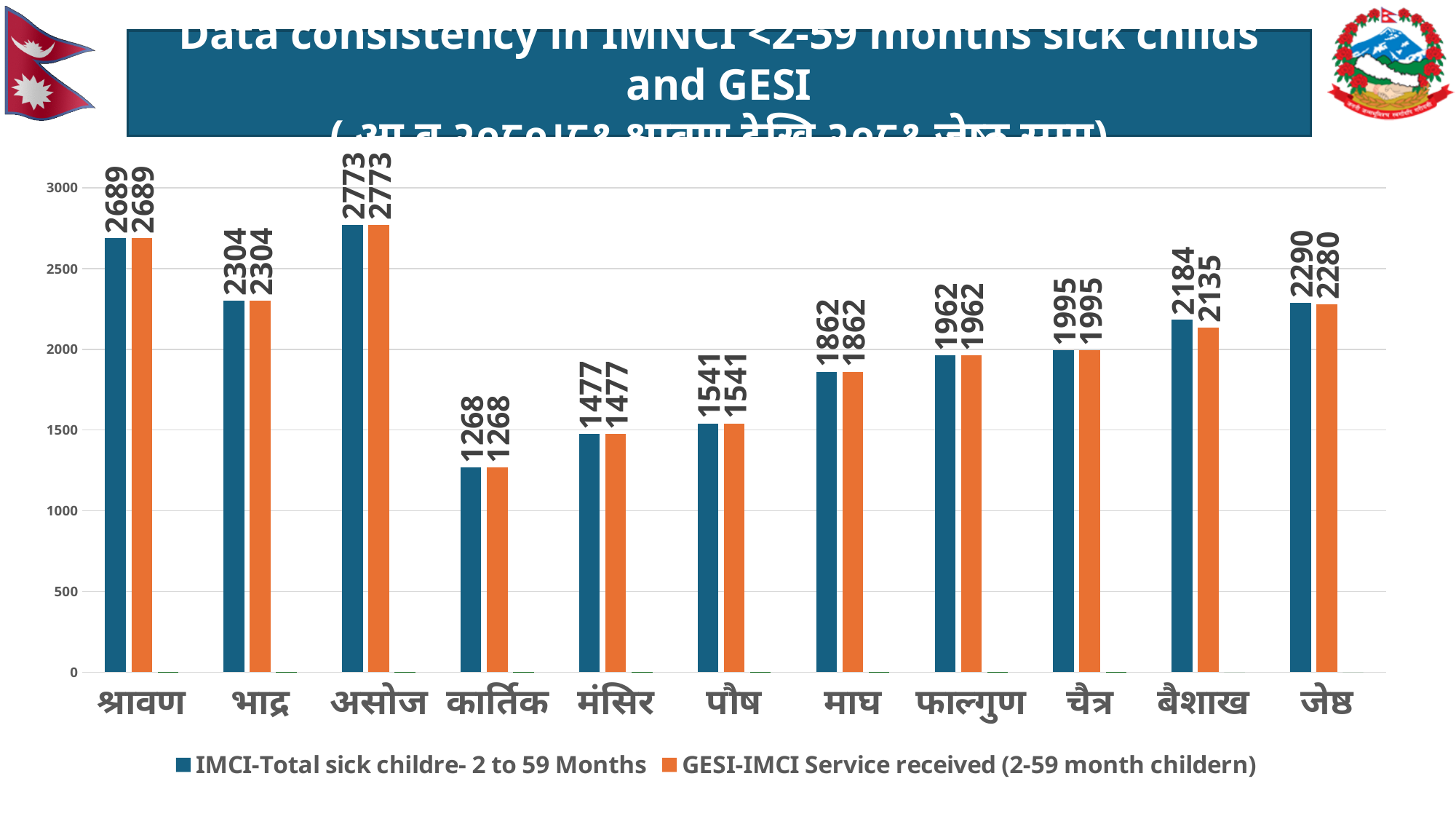
What is the value of IMCI-Total sick childre- 2 to 59 Months for श्रावण? 2689 Which month has the highest value for IMCI-Total sick childre- 2 to 59 Months? असोज What type of chart is shown on the slide? bar chart Which is larger for जेष्ठ: IMCI-Total sick childre- 2 to 59 Months or GESI-IMCI Service received (2-59 month childern)? IMCI-Total sick childre- 2 to 59 Months Which month has the lowest value for GESI-IMCI Service received (2-59 month childern)? कार्तिक What is the difference between IMCI-Total sick childre- 2 to 59 Months and GESI-IMCI Service received for बैशाख? 49 What is the value of GESI-IMCI Service received (2-59 month childern) for बैशाख? 2135 Which colour represents GESI-IMCI Service received (2-59 month childern) in the chart? orange What is the value of GESI-IMCI Service received (2-59 month childern) for जेष्ठ? 2280 How many months (categories) are shown on the x axis? 11 Is the value of IMCI-Total sick childre- 2 to 59 Months for मंसिर greater or less than 1500? less How many series does the legend list? 2